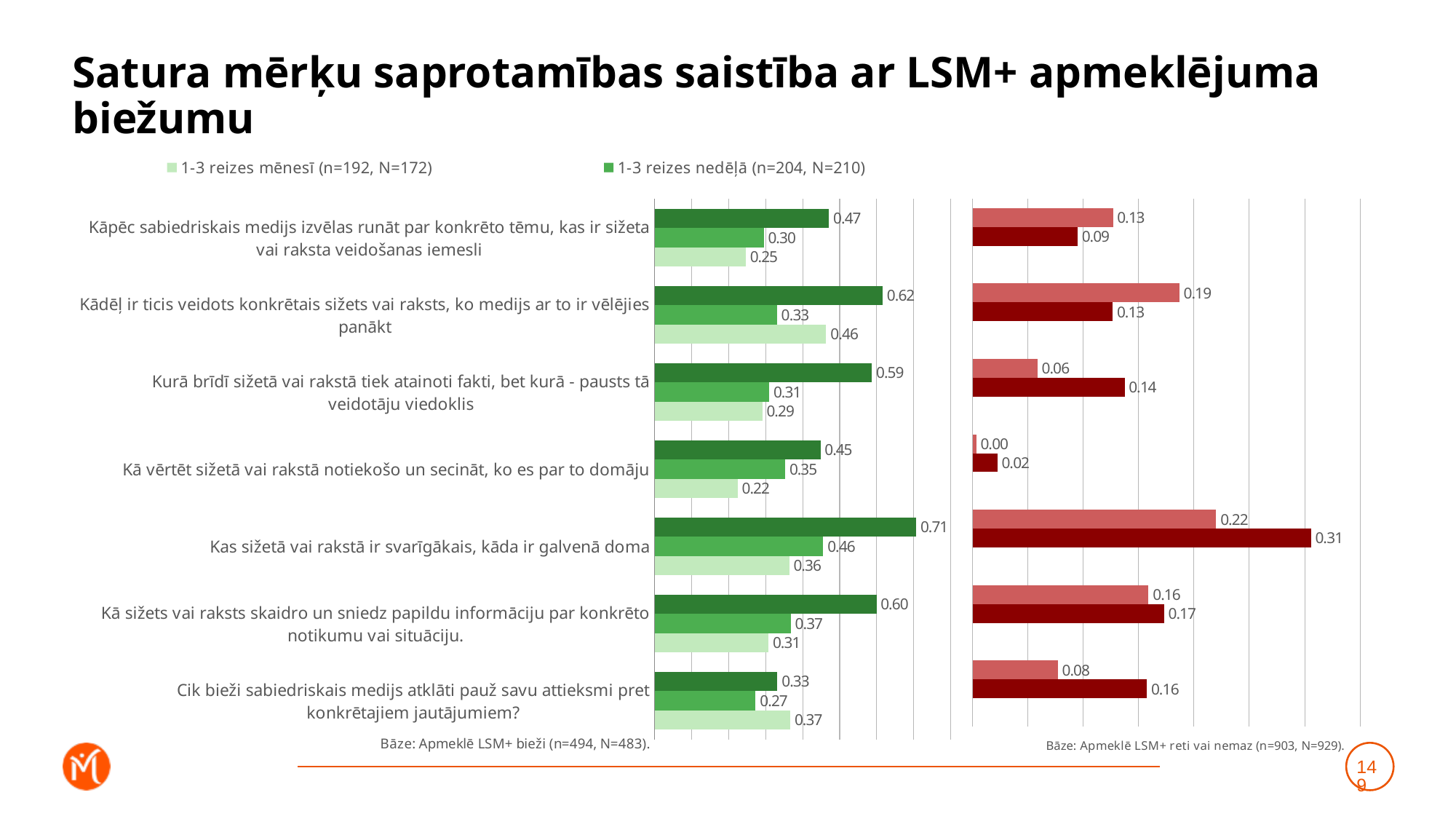
In the left chart (green bars), what is the value of the '1-3 reizes nedēļā' series for 'Kas sižetā vai rakstā ir svarīgākais, kāda ir galvenā doma'? 0.46 What type of chart is used on this slide? Bar chart How many categories (statements) are listed on the slide's charts? 7 In the right chart (red bars), what is the value of the light red bar for 'Kurā brīdī sižetā vai rakstā tiek atainoti fakti, bet kurā - pausts tā veidotāju viedoklis'? 0.06 In the left chart (green bars), which category has the highest dark green bar? Kas sižetā vai rakstā ir svarīgākais, kāda ir galvenā doma In the left chart (green bars), for 'Cik bieži sabiedriskais medijs atklāti pauž savu attieksmi pret konkrētajiem jautājumiem?', which series has the larger value: '1-3 reizes mēnesī' or '1-3 reizes nedēļā'? 1-3 reizes mēnesī In the left chart (green bars), what is the value of the '1-3 reizes mēnesī' series for 'Kādēļ ir ticis veidots konkrētais sižets vai raksts, ko medijs ar to ir vēlējies panākt'? 0.46 In the right chart (red bars), what is the lowest value shown? 0.00 In the left chart (green bars), what is the difference between the dark green bar and the '1-3 reizes mēnesī' bar for 'Kādēļ ir ticis veidots konkrētais sižets vai raksts, ko medijs ar to ir vēlējies panākt'? 0.16 How many series does the legend at the top of the slide list? 2 In the right chart (red bars), what is the highest value shown? 0.31 In the right chart (red bars), what is the value of the dark red bar for 'Kas sižetā vai rakstā ir svarīgākais, kāda ir galvenā doma'? 0.31